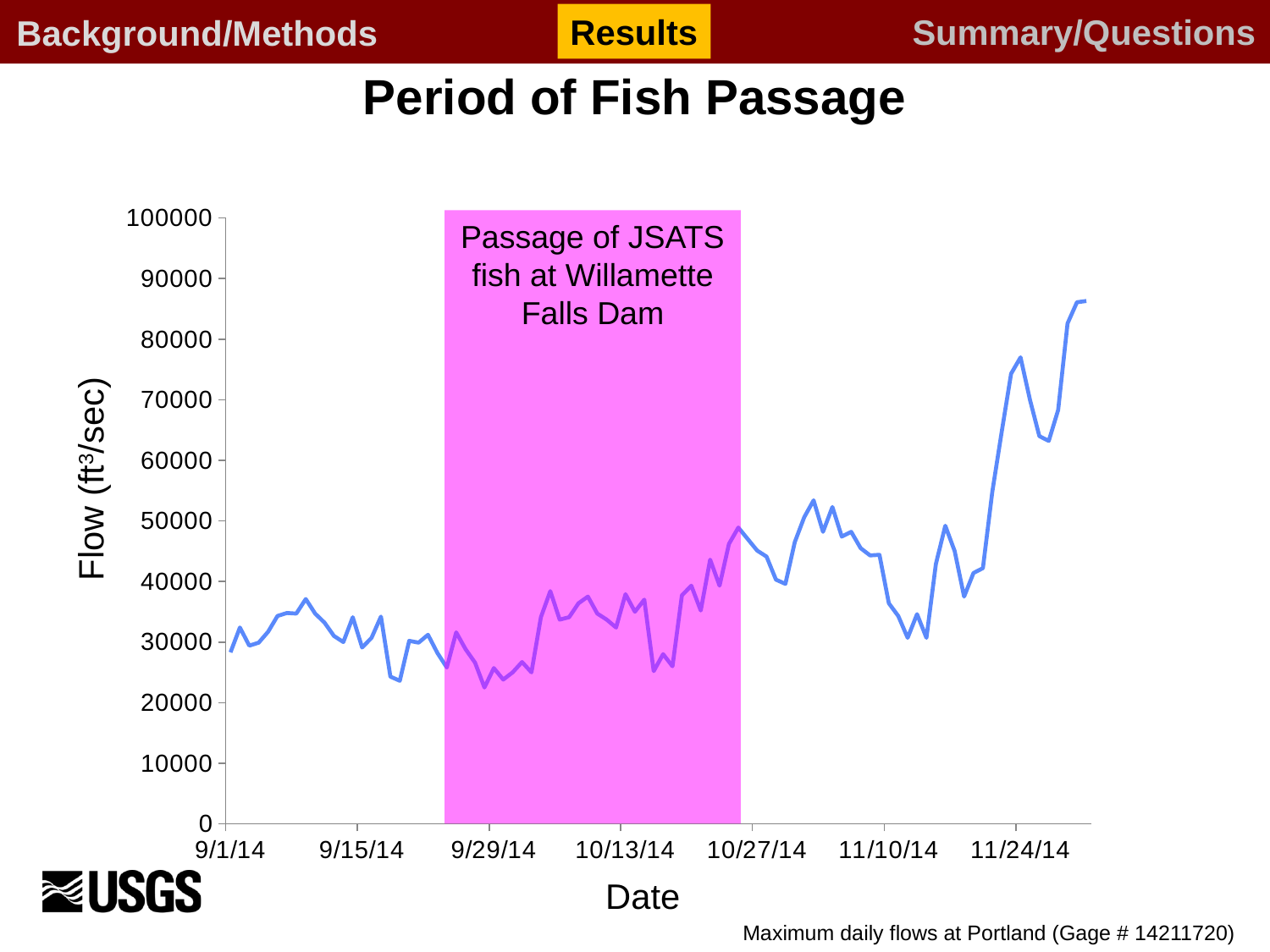
Does the flow generally rise or fall from the start of the chart to the end? Rise Near which labelled x-axis date does the flow reach its lowest point? 9/29/14 Is the flow value on 10/27/14 greater or less than 40000? greater Which date has the larger flow value, 9/1/14 or 11/24/14? 11/24/14 What kind of chart is shown on the slide? Line chart What is the title of the chart? Period of Fish Passage Is the flow value on 9/15/14 greater or less than 40000? less What does the shaded region on the chart represent, according to its label? Passage of JSATS fish at Willamette Falls Dam Is the flow value on 11/24/14 greater or less than 70000? greater Which date has the larger flow value, 9/29/14 or 10/27/14? 10/27/14